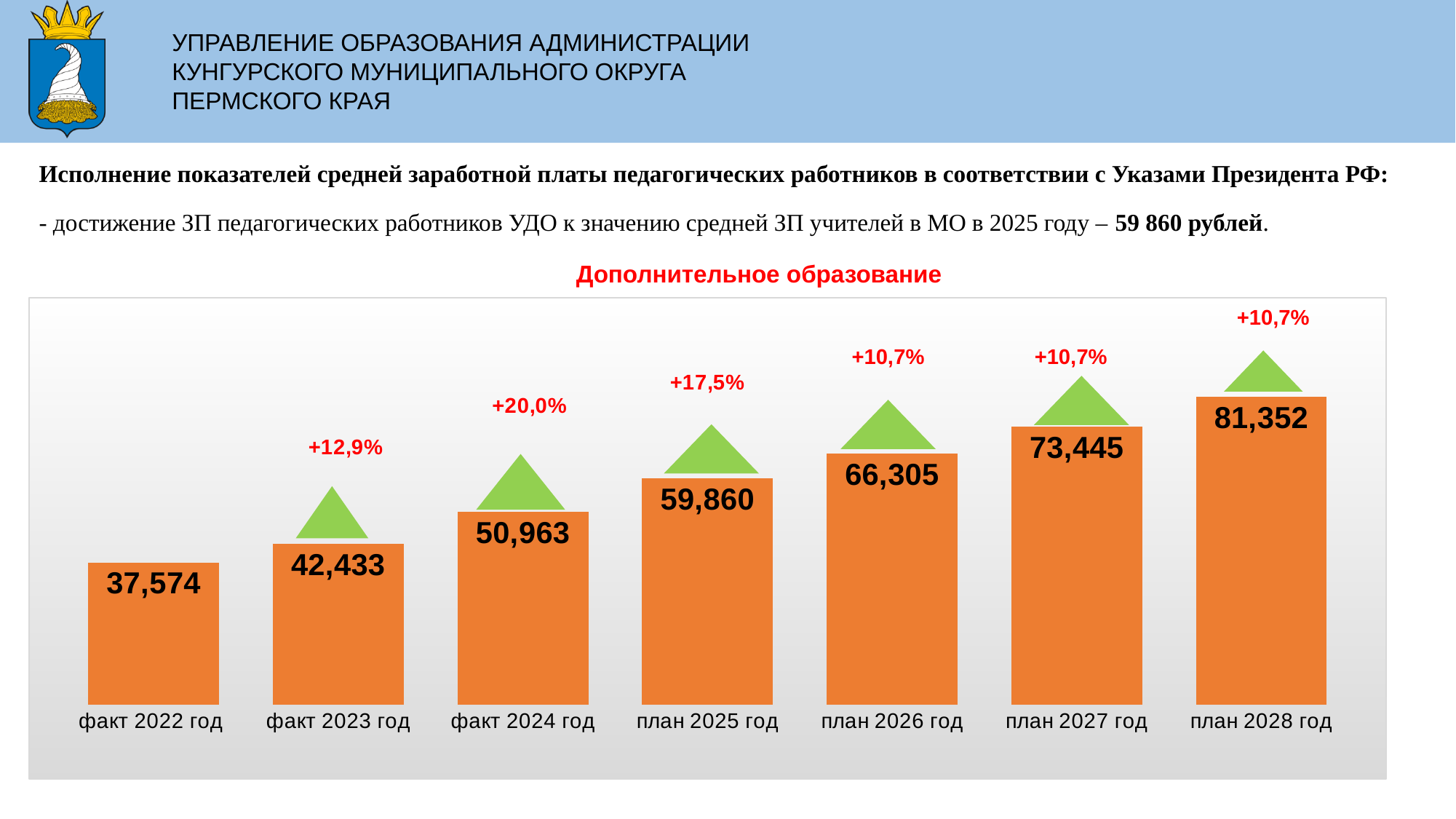
What percentage growth is shown above the bar for факт 2024 год? +20,0% What is the value for план 2028 год? 81,352 How many categories are shown on the x axis? 7 Do the values rise or fall from факт 2022 год to план 2028 год? rise Which category has the lowest value? факт 2022 год What kind of chart is this? bar chart Which is larger, the value for факт 2024 год or the value for план 2026 год? план 2026 год What is the value for план 2025 год? 59,860 What is the value for факт 2022 год? 37,574 What is the difference between the values for факт 2023 год and факт 2022 год? 4,859 Which category has the highest value? план 2028 год What is the difference between the values for план 2028 год and план 2027 год? 7,907